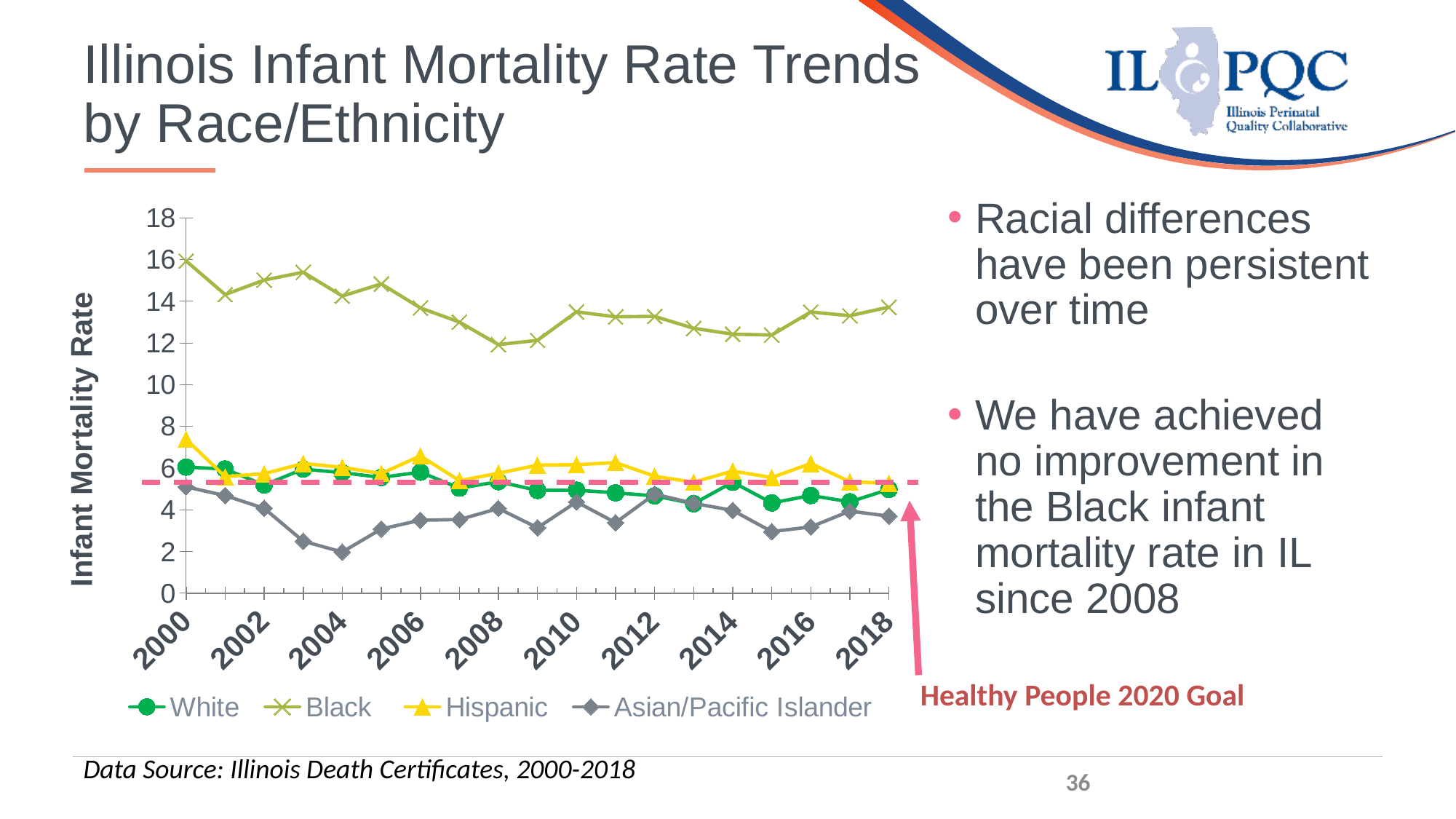
Is the infant mortality rate for Hispanic in 2000 greater or less than 6? greater Which race/ethnicity series has the highest infant mortality rate across the chart? Black Which race/ethnicity series has the lowest infant mortality rate in 2004? Asian/Pacific Islander Does the Asian/Pacific Islander infant mortality rate rise or fall from 2000 to 2004? Fall Which is larger in 2010, the infant mortality rate for Black or for White? Black Is the infant mortality rate for Asian/Pacific Islander in 2004 greater or less than 4? less How many series does the chart legend list? 4 What does the dashed horizontal line on the chart represent? Healthy People 2020 Goal Is the infant mortality rate for Black in 2000 greater or less than 14? greater What is the label on the y axis of the chart? Infant Mortality Rate What kind of chart is shown on the slide? Line chart